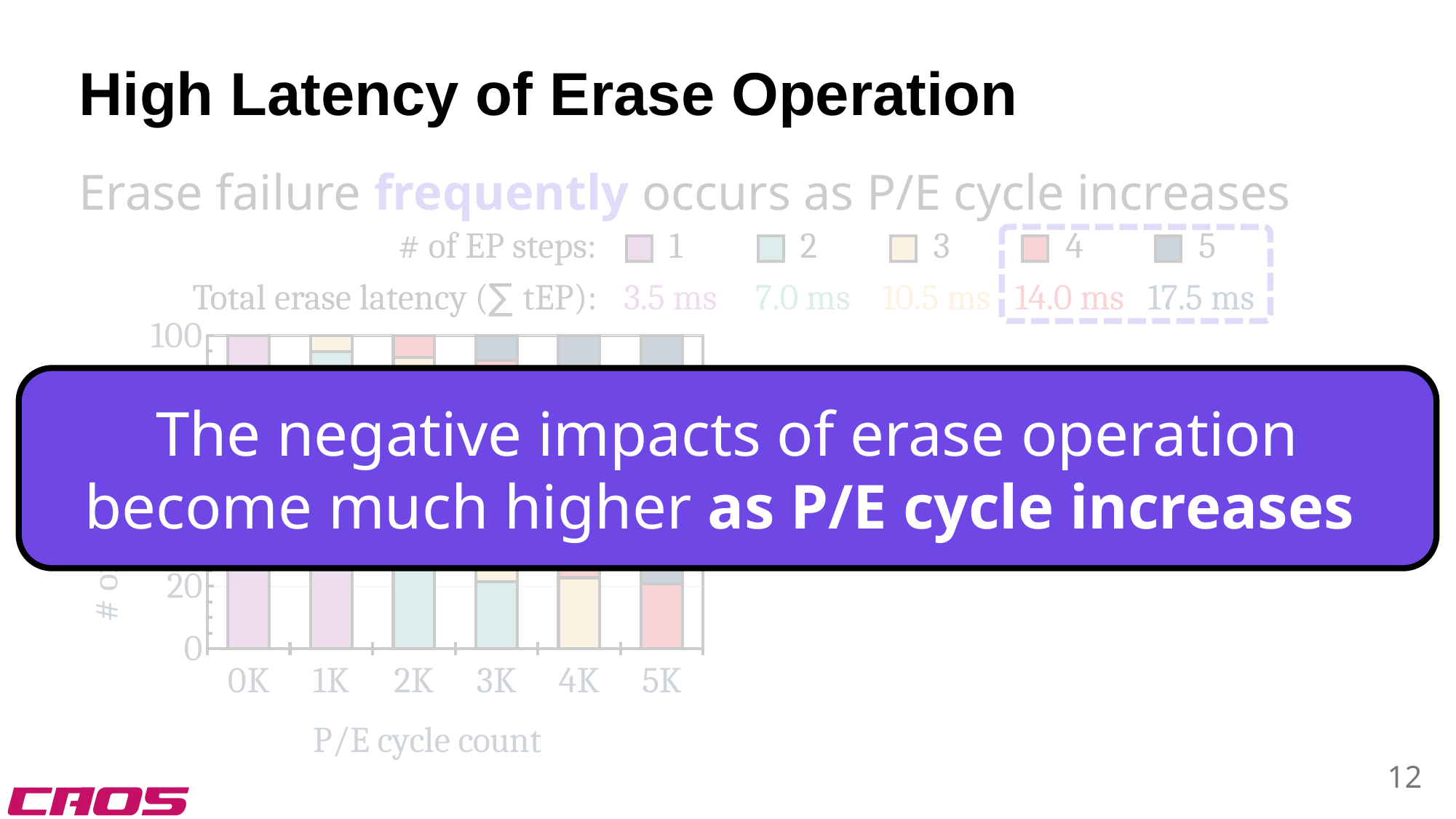
What kind of chart is shown on the slide? stacked bar chart Which series makes up the entire stacked bar at 0K P/E cycles? 1 Which total erase latency is larger, the one for 2 EP steps or the one for 3 EP steps? 3 EP steps (10.5 ms) How many P/E cycle count categories are shown on the x axis of the chart? 6 How many series (# of EP steps) does the chart legend list? 5 What is the difference between the total erase latency for 5 EP steps and for 1 EP step? 14.0 ms What total erase latency is printed for 5 EP steps? 17.5 ms Is the value for series 1 at 0K P/E cycles greater or less than 20? greater What total erase latency is printed for 1 EP step? 3.5 ms What is the title of the chart legend? # of EP steps What total erase latency is printed for 4 EP steps? 14.0 ms What is the label of the x axis of the chart? P/E cycle count